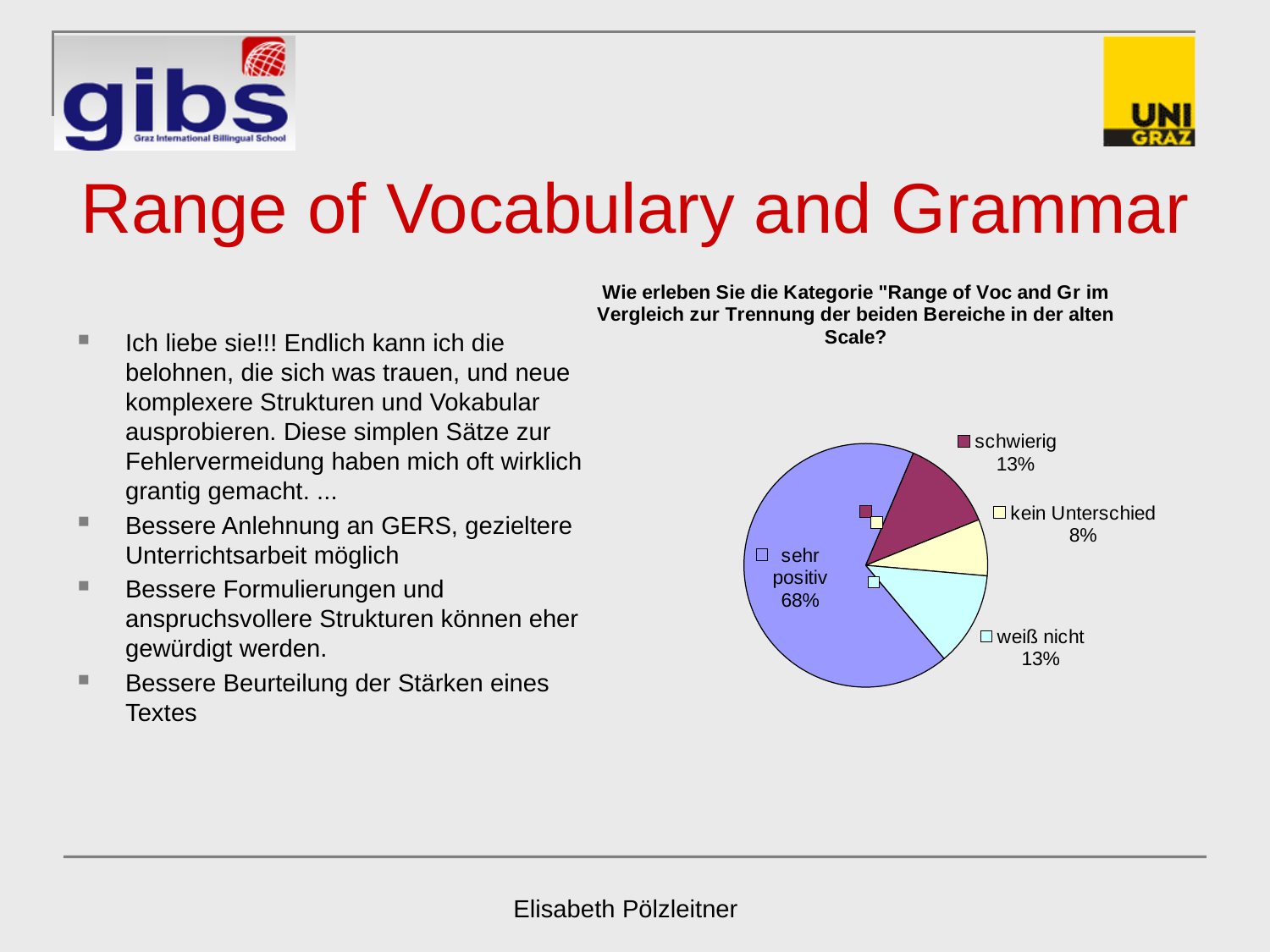
What is the combined share of "schwierig" and "weiß nicht"? 26% What share of the pie does "sehr positiv" have? 68% What is the difference in percentage points between "sehr positiv" and "schwierig"? 55 What share of the pie does "schwierig" have? 13% How many slices does the pie chart have? 4 Which slice of the pie is the smallest? kein Unterschied Which slice of the pie is the largest? sehr positiv Is the share for "sehr positiv" greater or less than 50%? greater What kind of chart is shown on the slide? pie chart What share of the pie does "kein Unterschied" have? 8% Which is larger, the share for "schwierig" or the share for "kein Unterschied"? schwierig What share of the pie does "weiß nicht" have? 13%